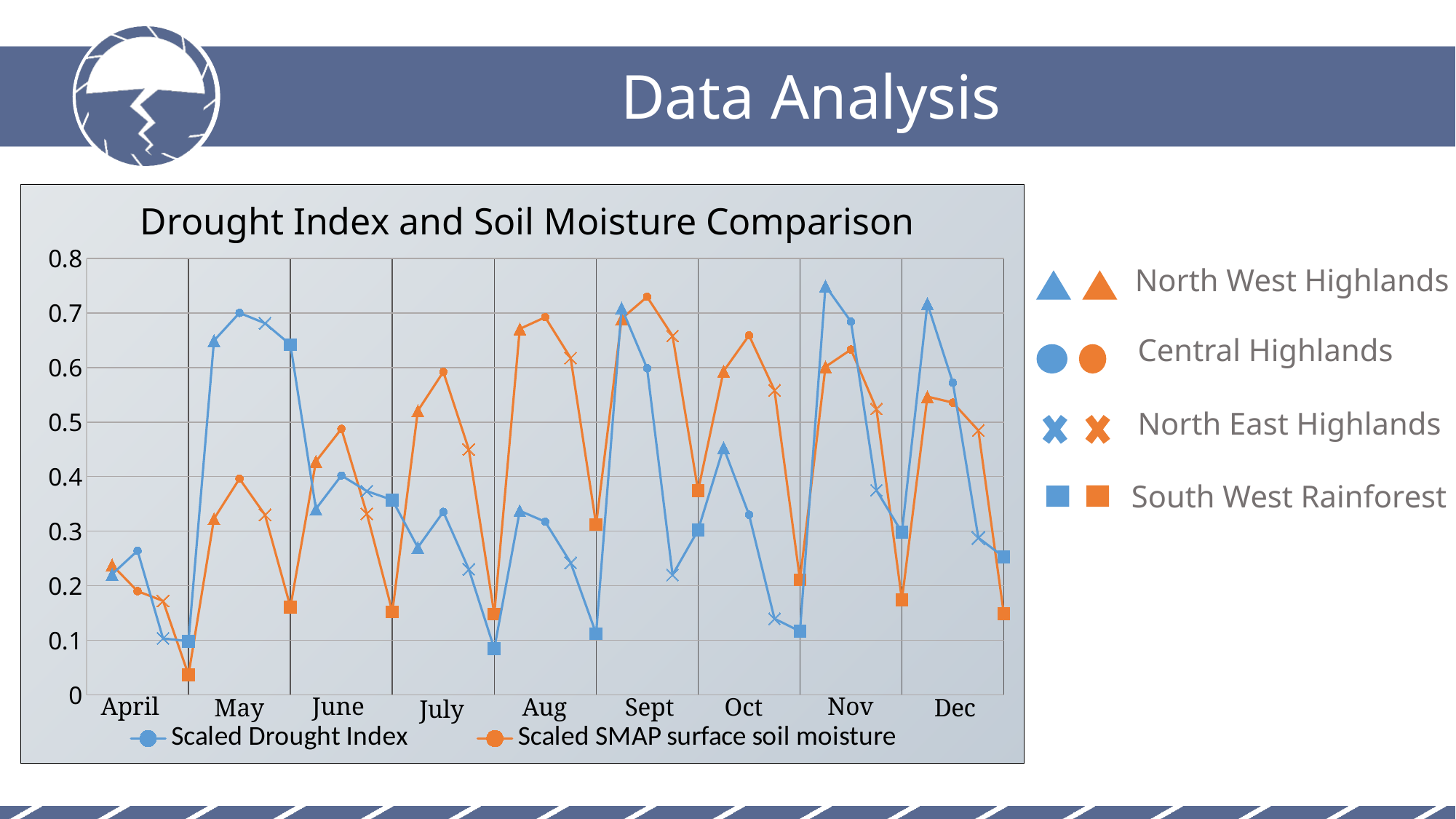
Is the Scaled Drought Index value for Central Highlands in May greater or less than 0.6? greater Is the Scaled Drought Index value for North West Highlands in Nov greater or less than 0.7? greater How many months are shown along the x axis? 9 Is the Scaled Drought Index value for South West Rainforest in July greater or less than 0.1? less Which marker shape is used for Central Highlands in the legend on the right? circle What is the title of the chart? Drought Index and Soil Moisture Comparison What kind of chart is shown on the slide? line chart In May, which is larger for Central Highlands: the Scaled Drought Index or the Scaled SMAP surface soil moisture? Scaled Drought Index How many series does the chart legend at the bottom list? 2 In Sept, which is larger for Central Highlands: the Scaled Drought Index or the Scaled SMAP surface soil moisture? Scaled SMAP surface soil moisture